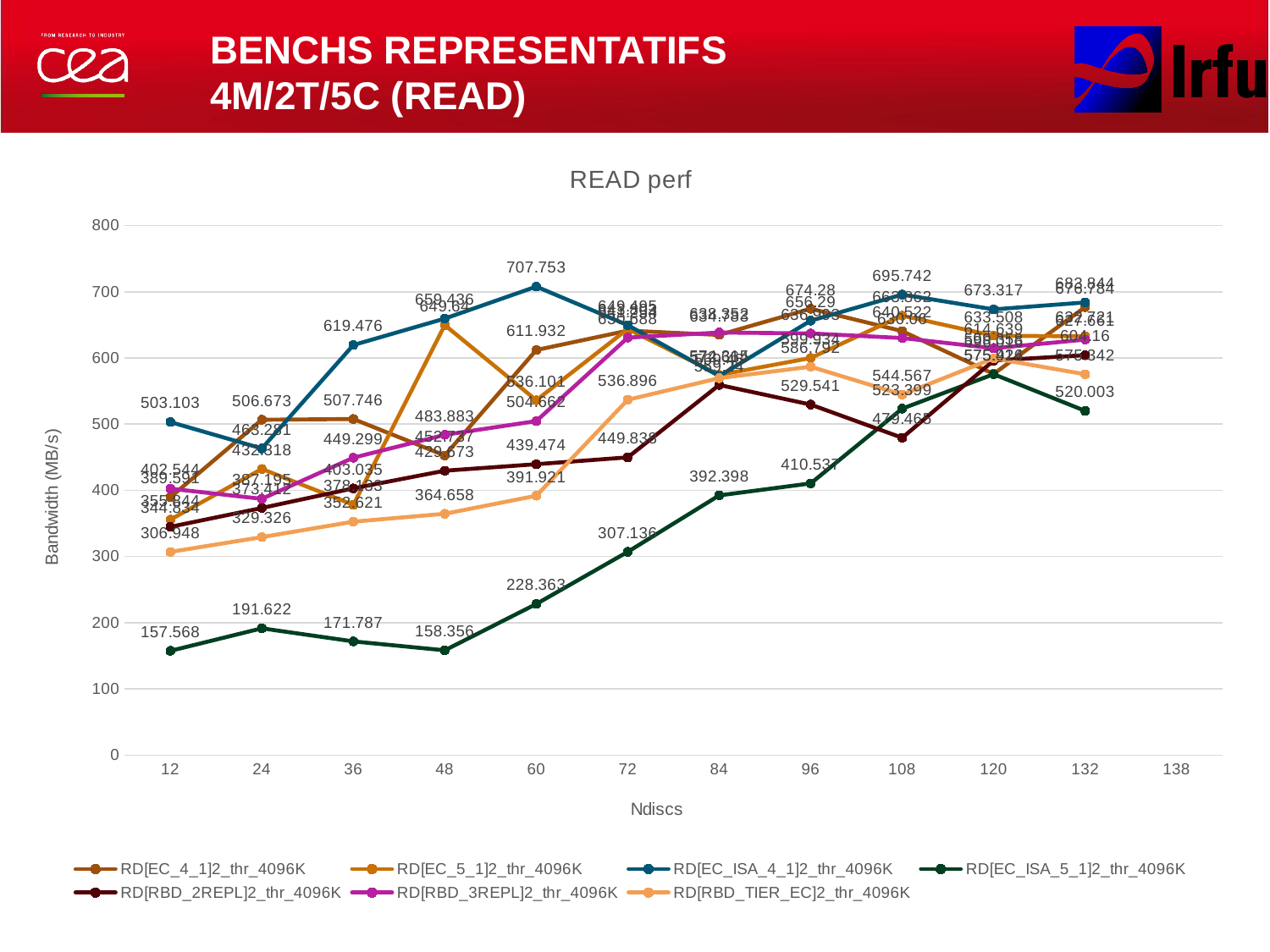
What is the lowest value plotted on the chart? 157.568 How many series does the legend list? 7 At 12 Ndiscs, which is larger: RD[EC_ISA_4_1]2_thr_4096K or RD[EC_ISA_5_1]2_thr_4096K? RD[EC_ISA_4_1]2_thr_4096K What is the label of the y axis? Bandwidth (MB/s) What is the highest value plotted on the chart, and for which series? 707.753, RD[EC_ISA_4_1]2_thr_4096K What is the difference between the RD[EC_ISA_4_1]2_thr_4096K values at 60 and 36 Ndiscs? 88.277 What is the value of RD[EC_ISA_5_1]2_thr_4096K at 72 Ndiscs? 307.136 Is the value for RD[EC_ISA_5_1]2_thr_4096K at 108 Ndiscs greater or less than 400? greater What is the title of the chart? READ perf What is the value of RD[EC_ISA_5_1]2_thr_4096K at 132 Ndiscs? 520.003 What kind of chart is shown on the slide? line chart What is the value of RD[EC_ISA_4_1]2_thr_4096K at 36 Ndiscs? 619.476